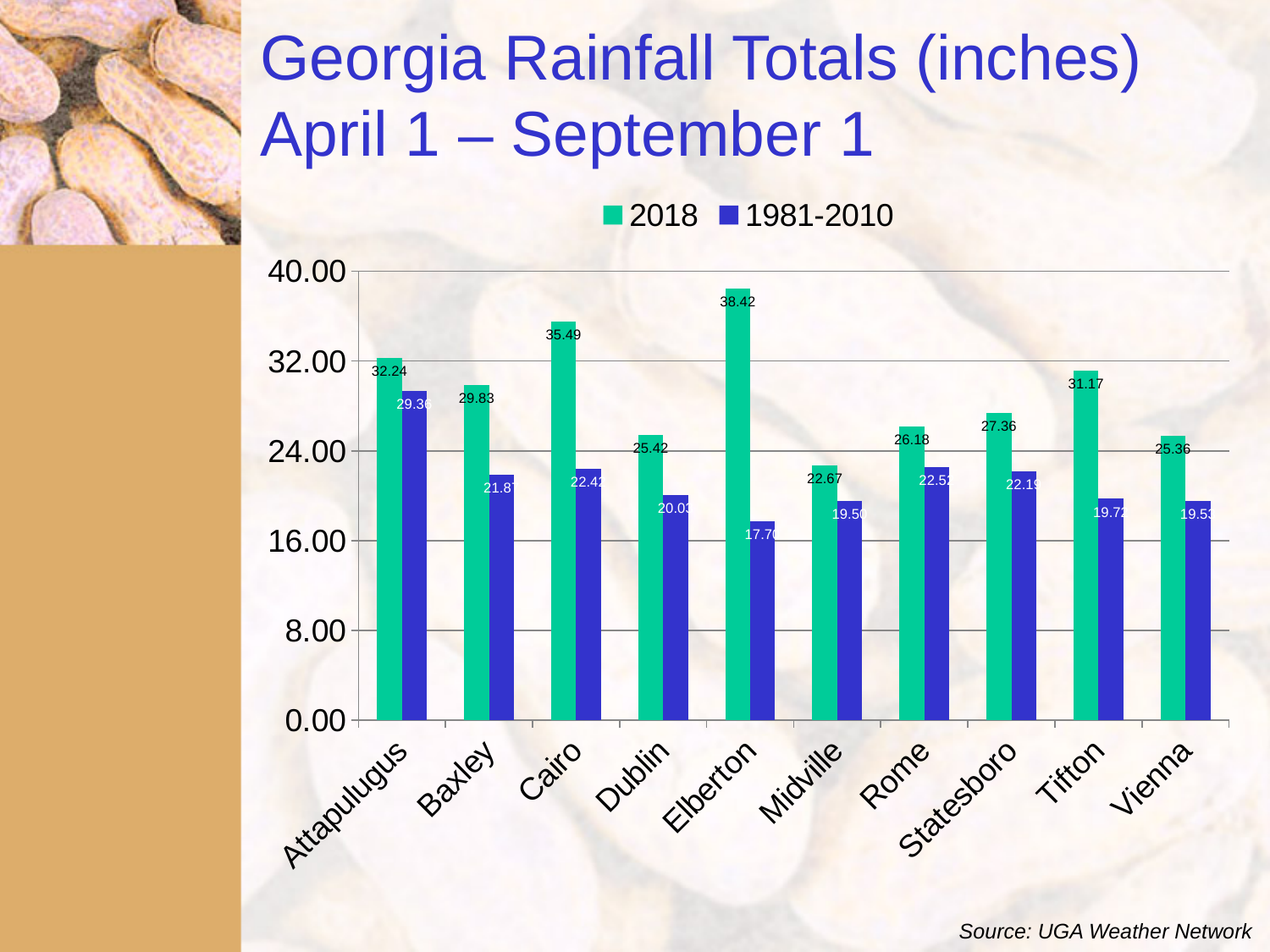
Which location has the highest 2018 rainfall total? Elberton What is the difference between the 2018 and 1981-2010 rainfall totals for Elberton? 20.72 What is the 1981-2010 rainfall total for Rome? 22.52 For Attapulugus, which is larger: the 2018 total or the 1981-2010 total? 2018 What is the 2018 rainfall total for Elberton? 38.42 Which location has the lowest 1981-2010 rainfall total? Elberton How many locations are shown on the x axis? 10 What is the 2018 rainfall total for Cairo? 35.49 What kind of chart is shown on the slide? bar chart Which location has the lowest 2018 rainfall total? Midville How many series does the legend list? 2 Is the 1981-2010 value for Tifton greater or less than 24.00? less